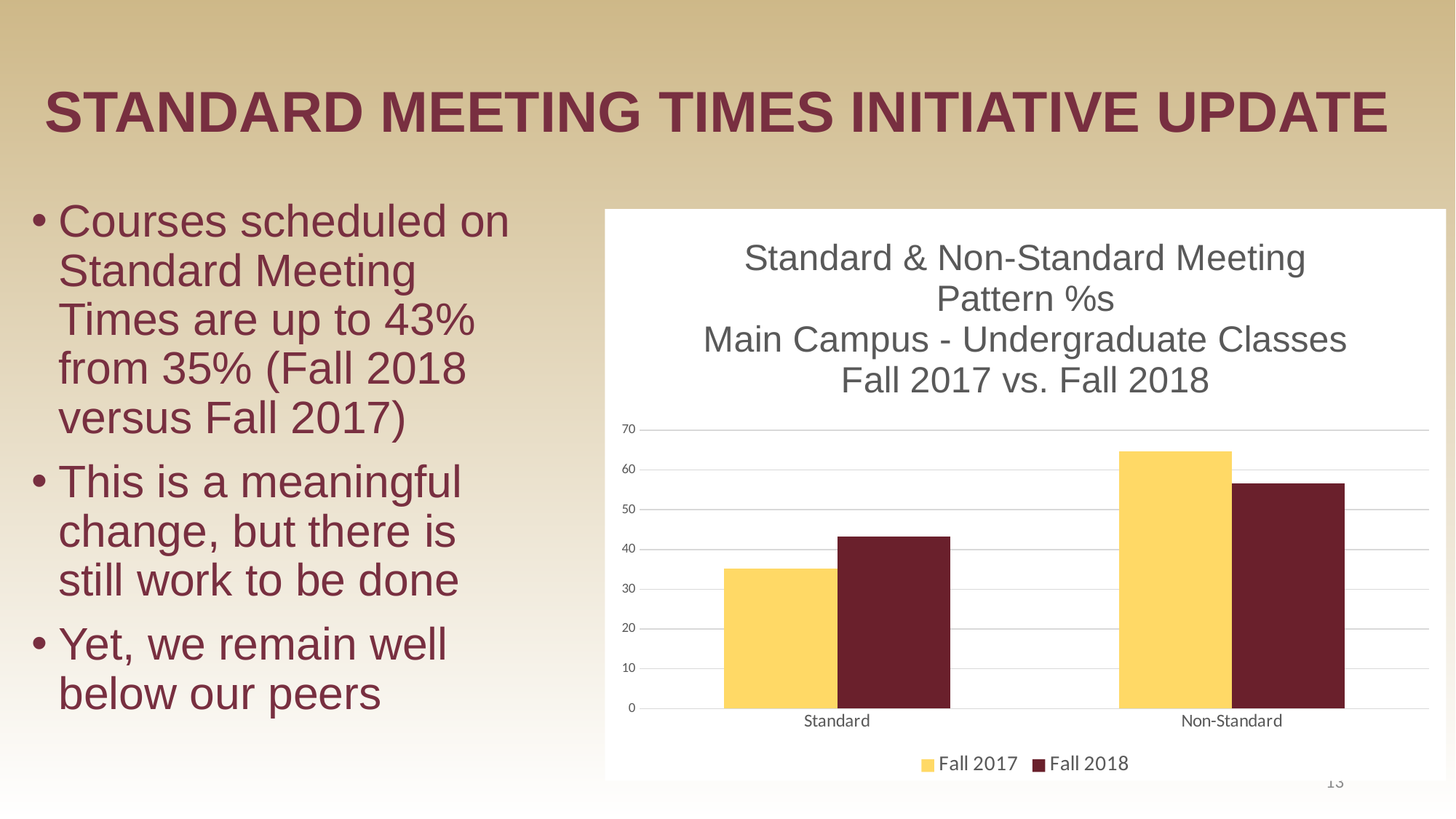
Is the Fall 2018 value for Standard greater or less than 40? greater Is the Fall 2017 value for Non-Standard greater or less than 60? greater For the Non-Standard category, which series has the larger value, Fall 2017 or Fall 2018? Fall 2017 How many series does the chart legend list? 2 Is the Fall 2017 value for Standard greater or less than 40? less For the Standard category, which series has the larger value, Fall 2017 or Fall 2018? Fall 2018 Which category and series has the shortest bar in the chart? Standard, Fall 2017 How many categories are shown on the x axis of the chart? 2 Which category and series has the tallest bar in the chart? Non-Standard, Fall 2017 What are the two entries in the chart legend? Fall 2017 and Fall 2018 What kind of chart is shown on the slide? Bar chart